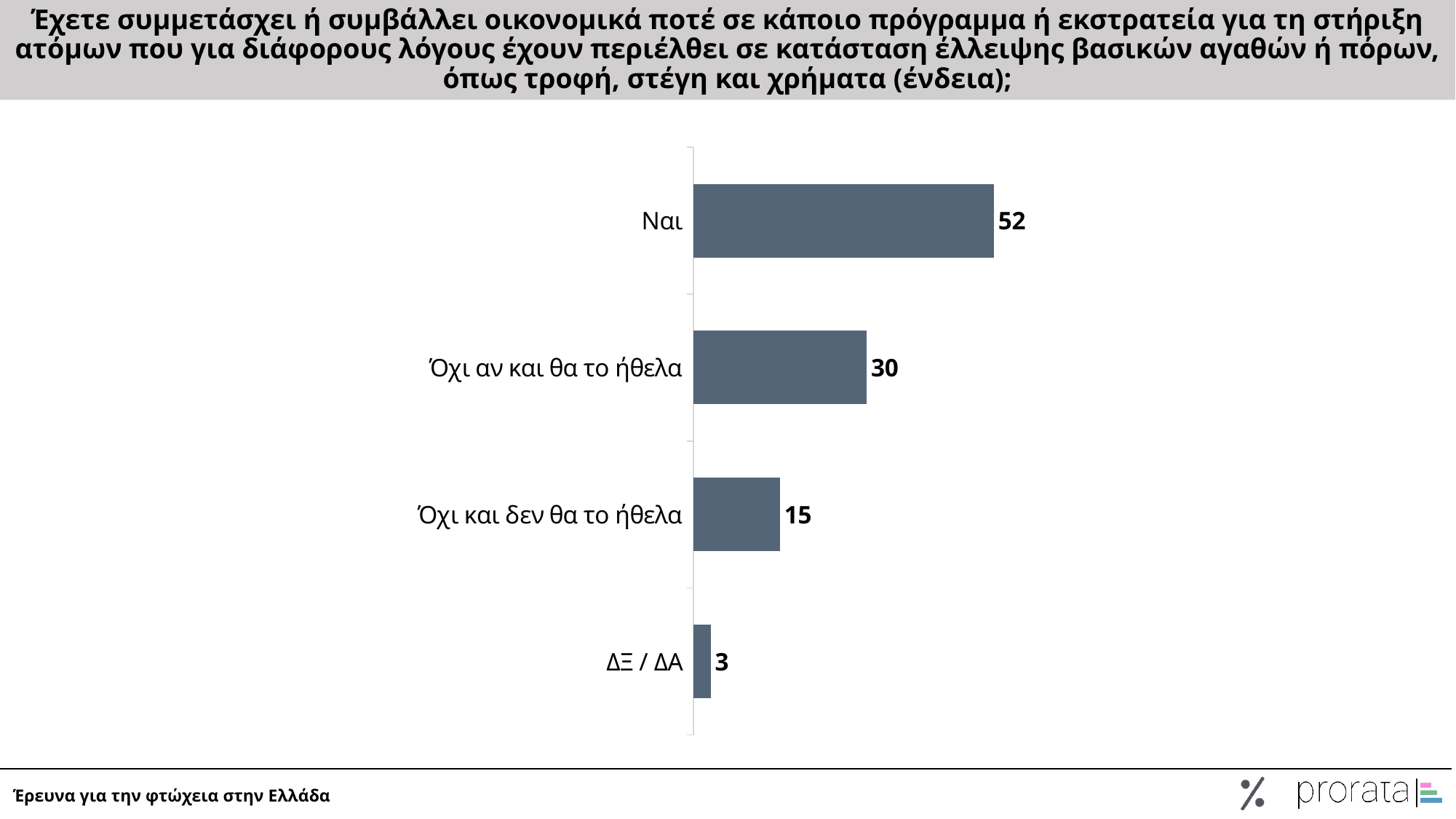
What is the value for "Όχι αν και θα το ήθελα"? 30 What kind of chart is shown on the slide? Bar chart What is the difference between the values for "Ναι" and "Όχι αν και θα το ήθελα"? 22 What is the difference between the values for "Όχι και δεν θα το ήθελα" and "ΔΞ / ΔΑ"? 12 What is the value for "Ναι"? 52 Which category has the lowest value? ΔΞ / ΔΑ What is the total of all four values shown in the chart? 100 What is the value for "Όχι και δεν θα το ήθελα"? 15 What is the value for "ΔΞ / ΔΑ"? 3 How many categories are shown in the chart? 4 Which category has the highest value? Ναι Which is larger, the value for "Όχι αν και θα το ήθελα" or the value for "Όχι και δεν θα το ήθελα"? Όχι αν και θα το ήθελα